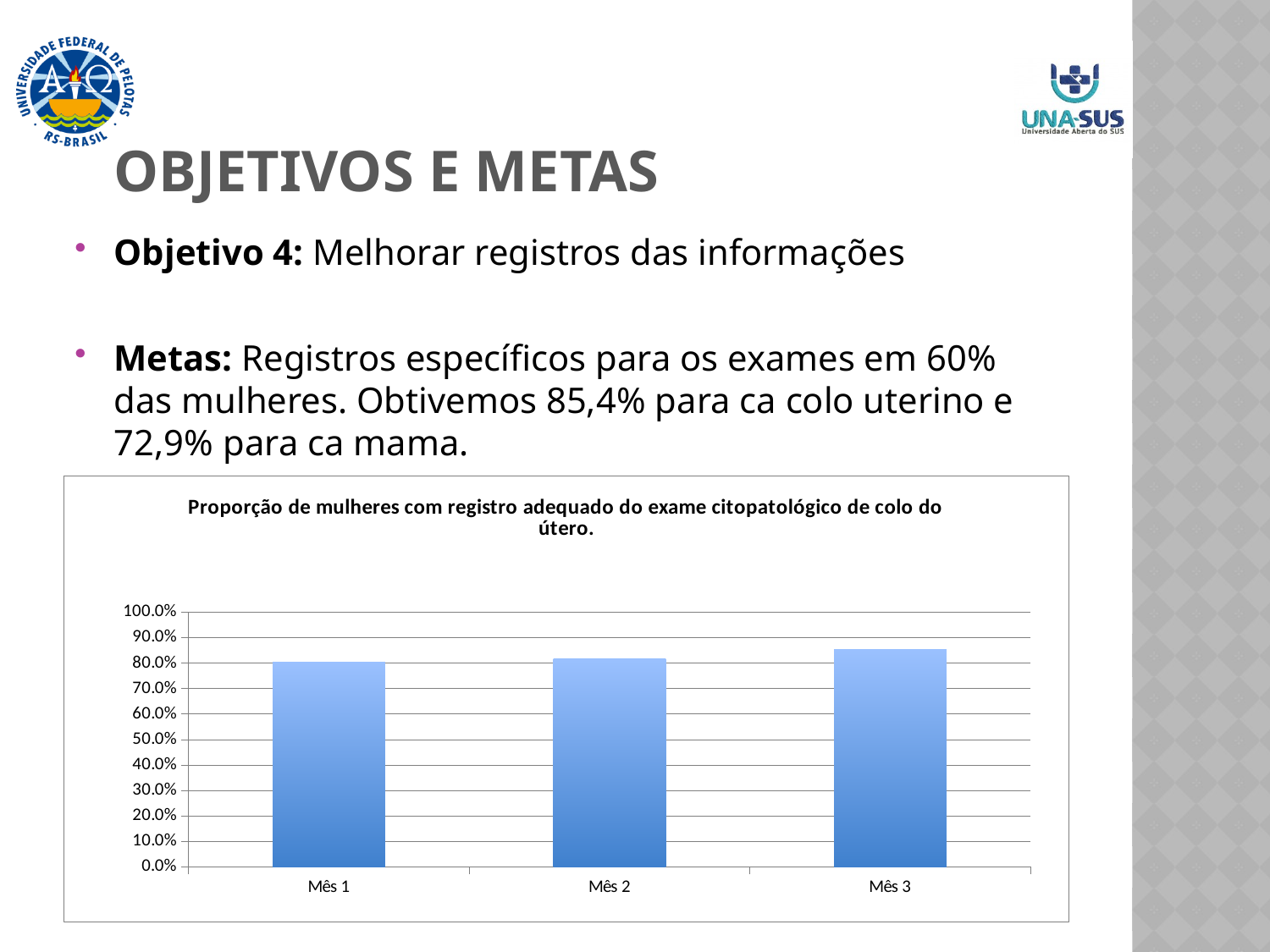
What kind of chart is shown on the slide? bar chart What is the highest value shown on the y axis of the chart? 100.0% What is the title of the chart? Proporção de mulheres com registro adequado do exame citopatológico de colo do útero. Which month has the highest value in the chart? Mês 3 Is the value for Mês 2 greater or less than 90.0%? less Do the values rise or fall from Mês 1 to Mês 3? rise Is the value for Mês 3 greater or less than 80.0%? greater Is the value for Mês 1 greater or less than 70.0%? greater How many categories are plotted on the x axis of the chart? 3 Which is larger, the value for Mês 1 or the value for Mês 3? Mês 3